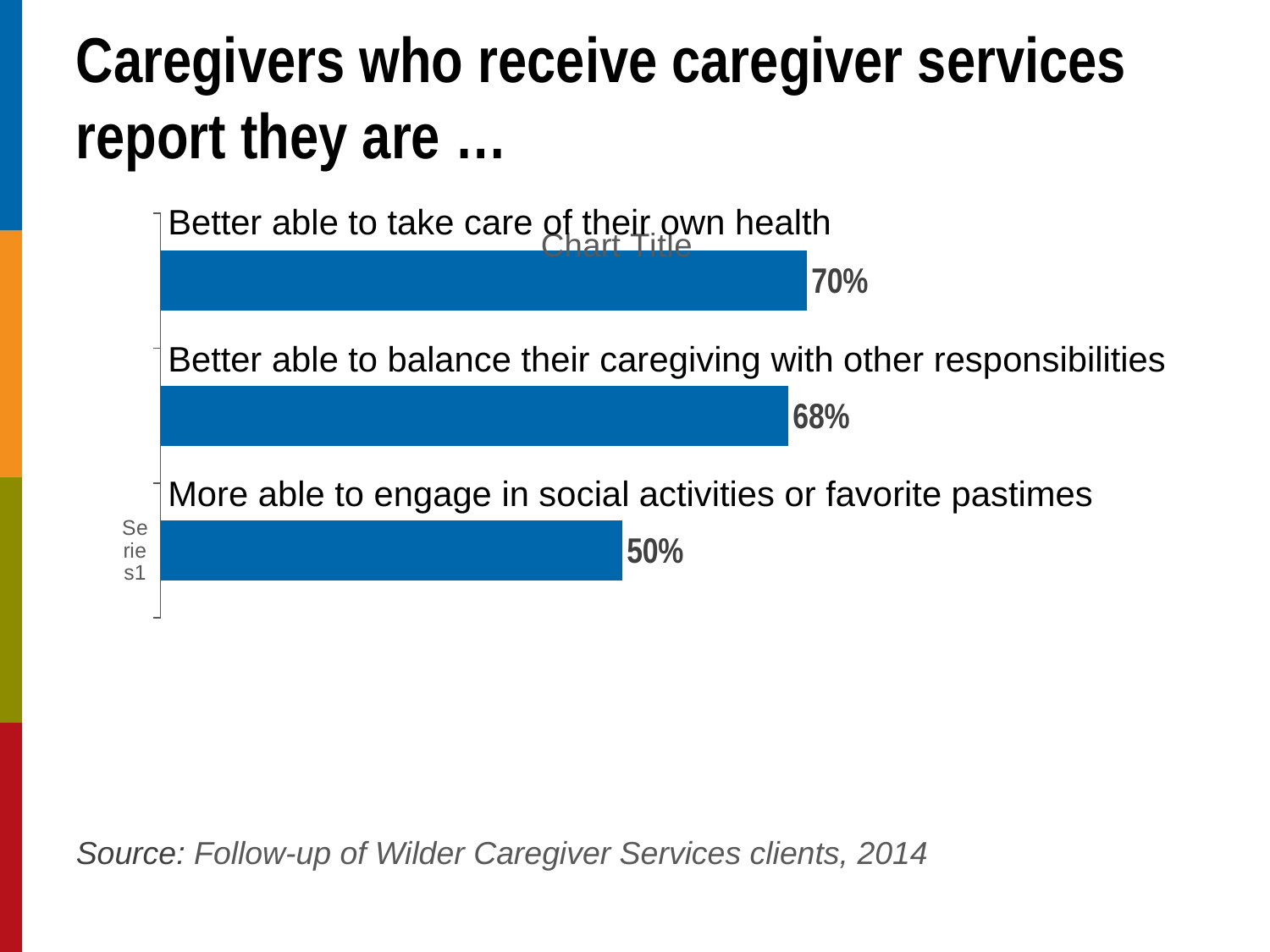
How many outcome categories are shown in the chart? 3 Which outcome has the highest percentage of caregivers reporting it? Better able to take care of their own health What percentage of caregivers report they are more able to engage in social activities or favorite pastimes? 50% What percentage of caregivers report they are better able to balance their caregiving with other responsibilities? 68% What is the difference in percentage points between 'Better able to balance their caregiving with other responsibilities' and 'More able to engage in social activities or favorite pastimes'? 18 percentage points What kind of chart is shown on the slide? Bar chart What is the difference in percentage points between 'Better able to take care of their own health' and 'More able to engage in social activities or favorite pastimes'? 20 percentage points Which is larger: the percentage for 'Better able to balance their caregiving with other responsibilities' or for 'More able to engage in social activities or favorite pastimes'? Better able to balance their caregiving with other responsibilities Which outcome has the lowest percentage of caregivers reporting it? More able to engage in social activities or favorite pastimes What colour are the bars in the chart? Blue What percentage of caregivers report they are better able to take care of their own health? 70% What is the source cited for the chart data? Follow-up of Wilder Caregiver Services clients, 2014